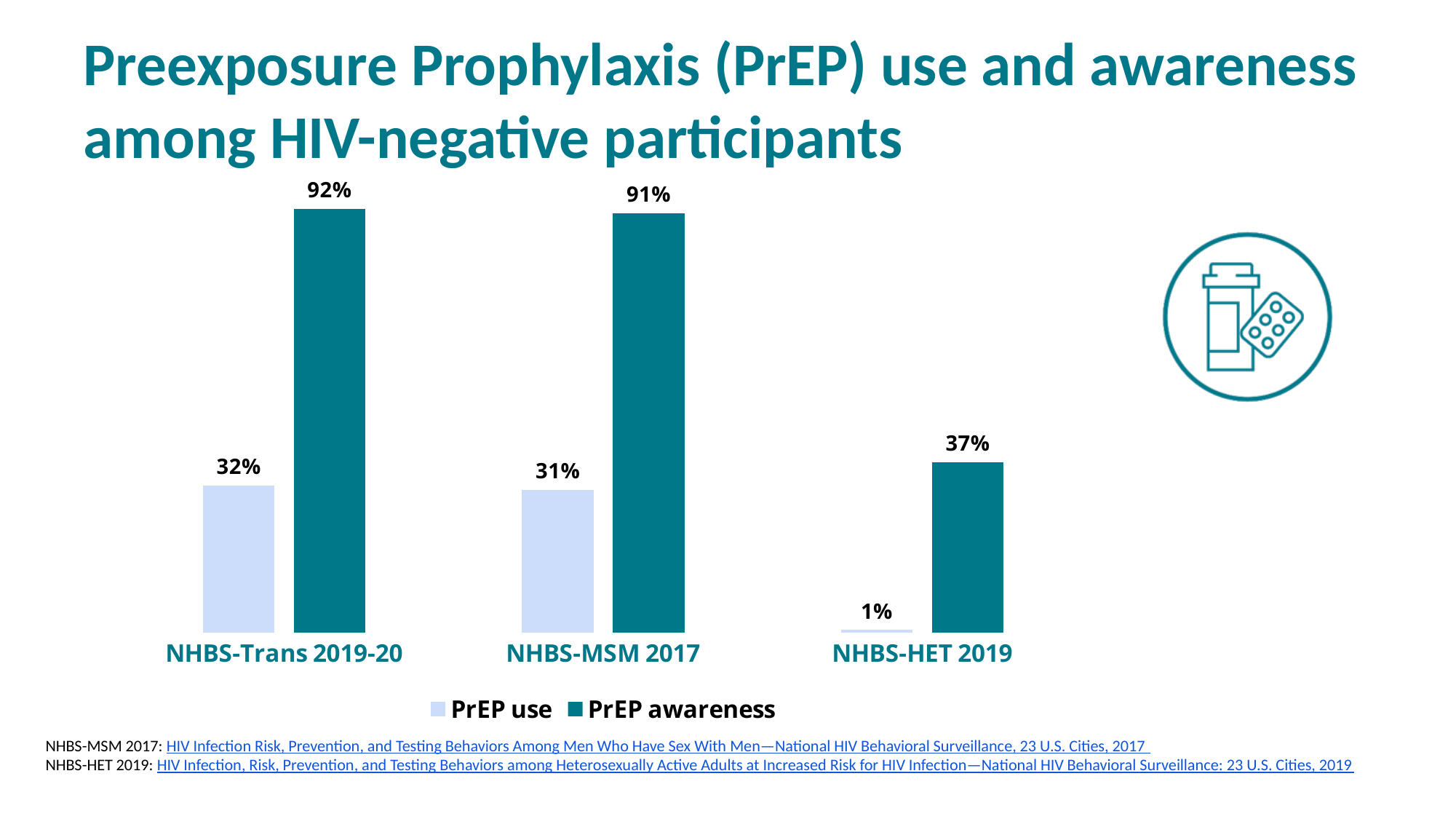
Which group has the lowest PrEP use? NHBS-HET 2019 Which group has the highest PrEP awareness? NHBS-Trans 2019-20 What kind of chart is shown on the slide? Bar chart How many groups are shown on the x axis of the chart? 3 What is the difference between PrEP awareness and PrEP use for NHBS-HET 2019? 36% What is the PrEP awareness value for NHBS-Trans 2019-20? 92% What is the PrEP use value for NHBS-HET 2019? 1% How many series does the legend list? 2 What is the PrEP use value for NHBS-MSM 2017? 31% Which series is shown in dark teal in the legend? PrEP awareness Which is larger: PrEP use for NHBS-Trans 2019-20 or PrEP use for NHBS-HET 2019? NHBS-Trans 2019-20 What is the difference in PrEP awareness between NHBS-MSM 2017 and NHBS-HET 2019? 54%